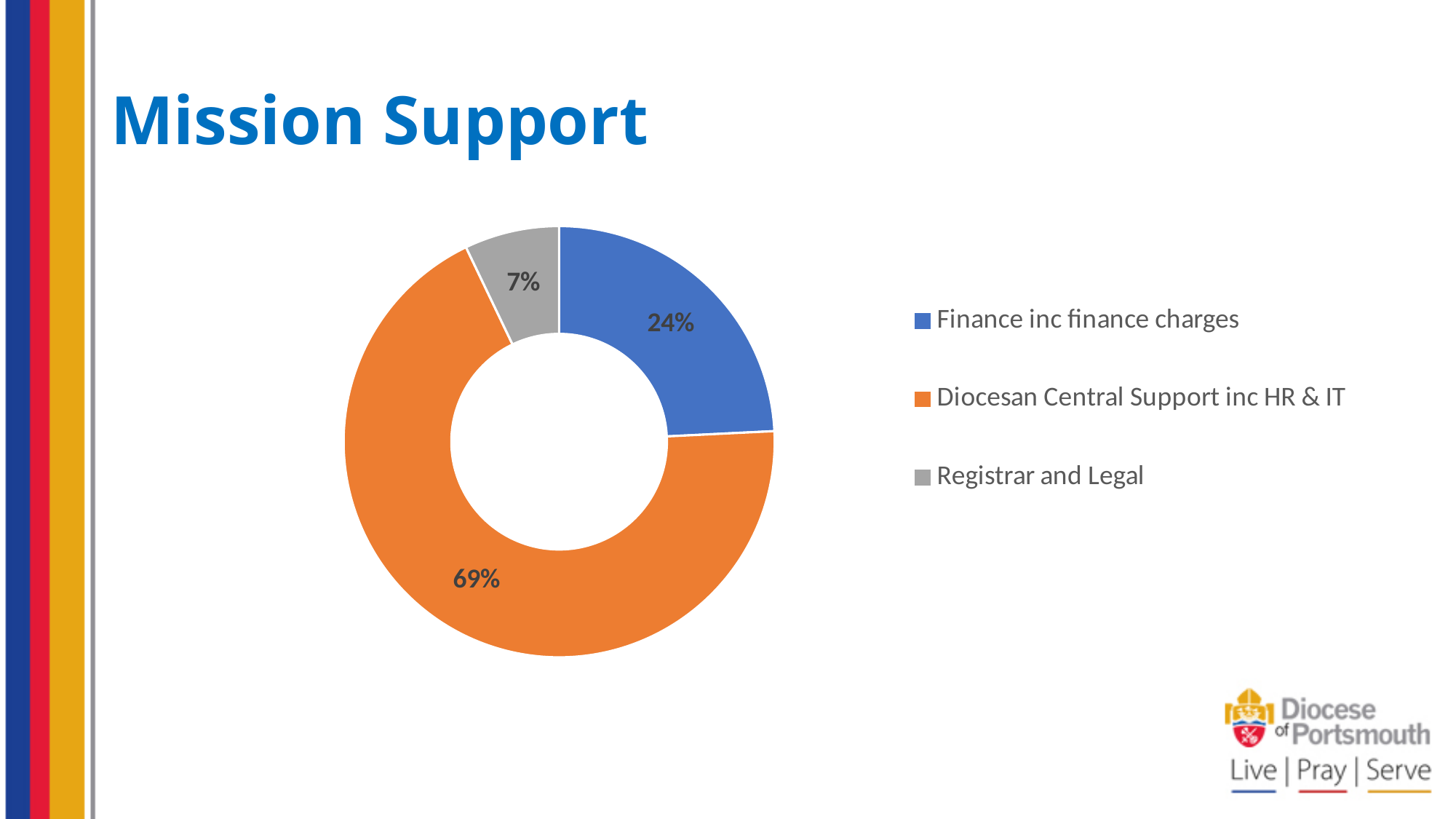
What colour represents Registrar and Legal in the chart? Grey Which category has the smallest share of the chart? Registrar and Legal How many categories does the chart show? 3 Which is larger: Finance inc finance charges or Registrar and Legal? Finance inc finance charges What share of Mission Support is Registrar and Legal? 7% What share of Mission Support is Finance inc finance charges? 24% What share of Mission Support is Diocesan Central Support inc HR & IT? 69% What kind of chart is shown on the slide? Doughnut (pie) chart How many percentage points larger is Diocesan Central Support inc HR & IT than Finance inc finance charges? 45 percentage points How many percentage points larger is Finance inc finance charges than Registrar and Legal? 17 percentage points Which category has the largest share of the chart? Diocesan Central Support inc HR & IT What is the title of the slide containing the chart? Mission Support